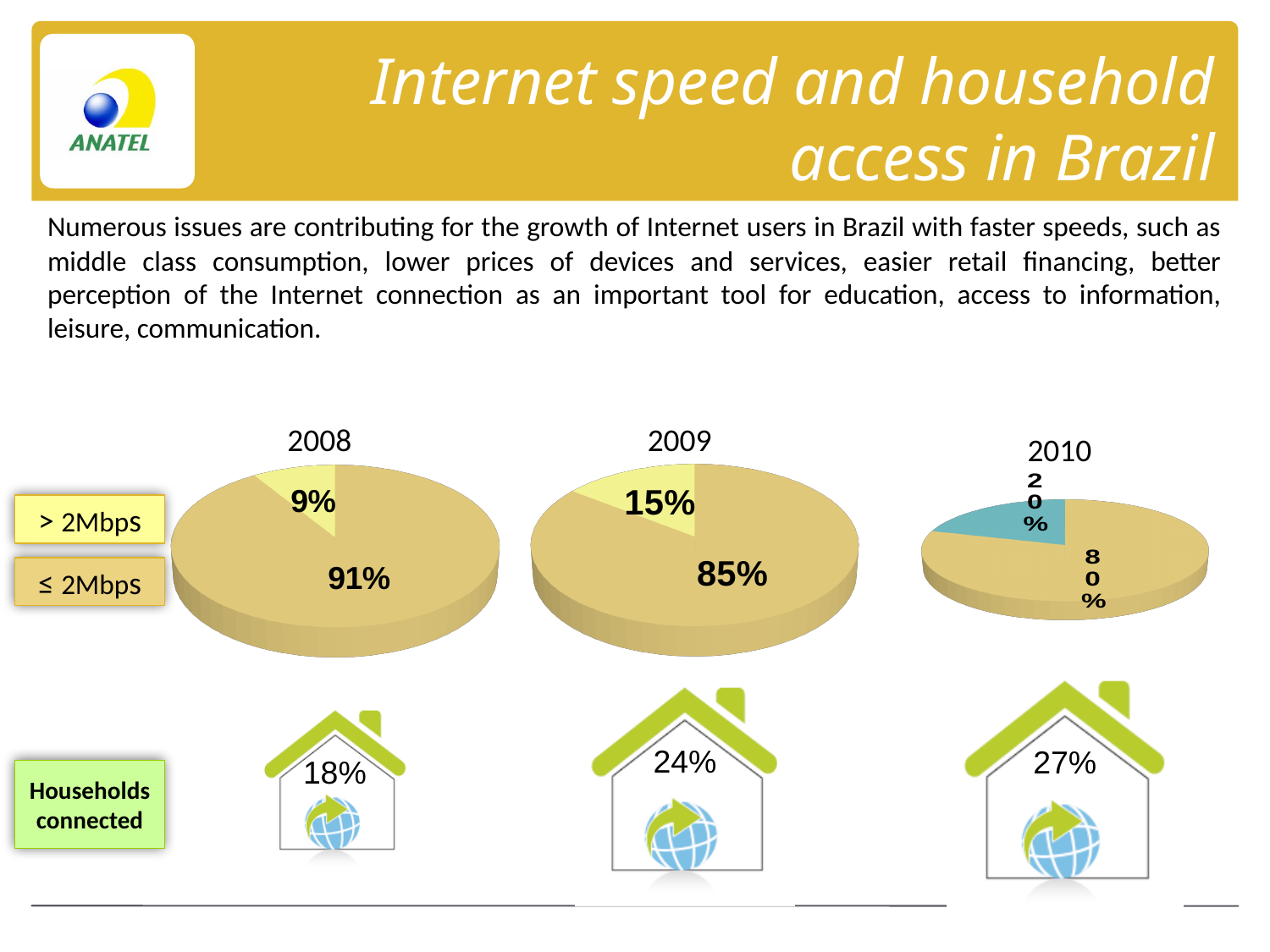
How many pie charts are shown on the slide? 3 In the 2009 pie chart, what share of connections is ≤ 2Mbps? 85% In the 2009 pie chart, what share of connections is > 2Mbps? 15% In the 2010 pie chart, what share of connections is > 2Mbps? 20% What kind of chart is used to show the Internet speed split for each year? Pie chart In the 2008 pie chart, what share of connections is > 2Mbps? 9% In the 2008 pie chart, what share of connections is ≤ 2Mbps? 91% By how many percentage points did the > 2Mbps share grow from the 2008 pie chart to the 2009 pie chart? 6 percentage points Which year's pie chart has the largest > 2Mbps slice? 2010 In the 2010 pie chart, what share of connections is ≤ 2Mbps? 80% Which year's pie chart has the smallest > 2Mbps slice? 2008 Does the > 2Mbps share rise or fall across the pie charts from 2008 to 2010? Rise